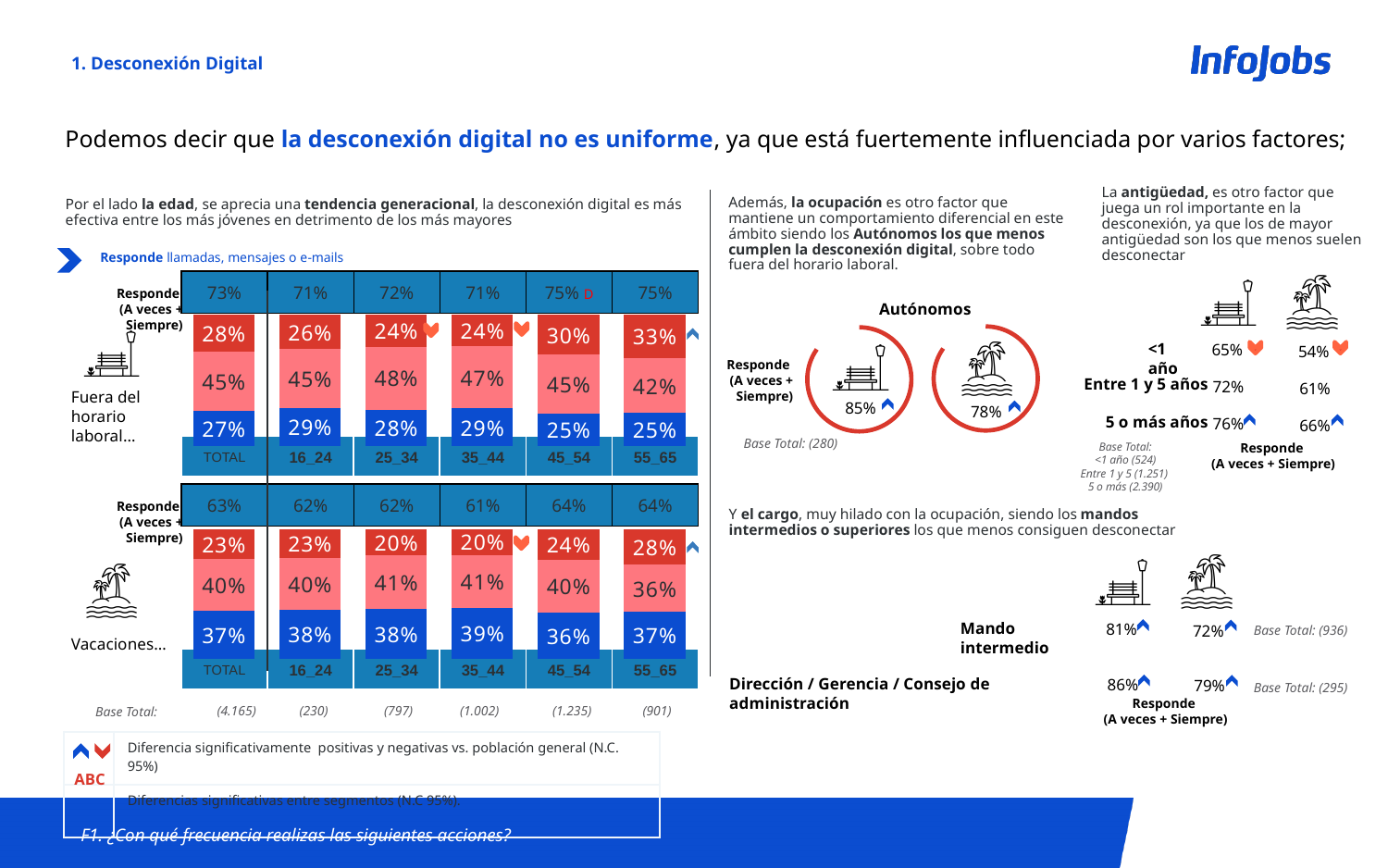
In the "Vacaciones" chart, is the blue (bottom) segment larger for 16_24 or for 45_54? 16_24 In the "Fuera del horario laboral" stacked bar chart, what is the value of the red (top) segment for the 55_65 age group? 33% How many categories are shown along the x axis of the "Fuera del horario laboral" chart? 6 In the "Fuera del horario laboral" chart, what is the total of the three segments of the TOTAL bar? 100% In the "Vacaciones" chart, which age group has the lowest pink (middle) segment? 55_65 What kind of chart is used for "Fuera del horario laboral" and "Vacaciones"? Stacked bar chart In the "Fuera del horario laboral" chart, what is the "Responde (A veces + Siempre)" value for the 45_54 age group? 75% In the "Vacaciones" chart, what is the "Responde (A veces + Siempre)" value for the 35_44 age group? 61% In the "Fuera del horario laboral" chart, what is the difference between the pink (middle) segment for 25_34 and for 55_65? 6 percentage points In the "Fuera del horario laboral" chart, which age group has the highest red (top) segment? 55_65 In the "Fuera del horario laboral" chart, which age group has the highest pink (middle) segment? 25_34 In the "Vacaciones" stacked bar chart, what is the value of the blue (bottom) segment for the 35_44 age group? 39%